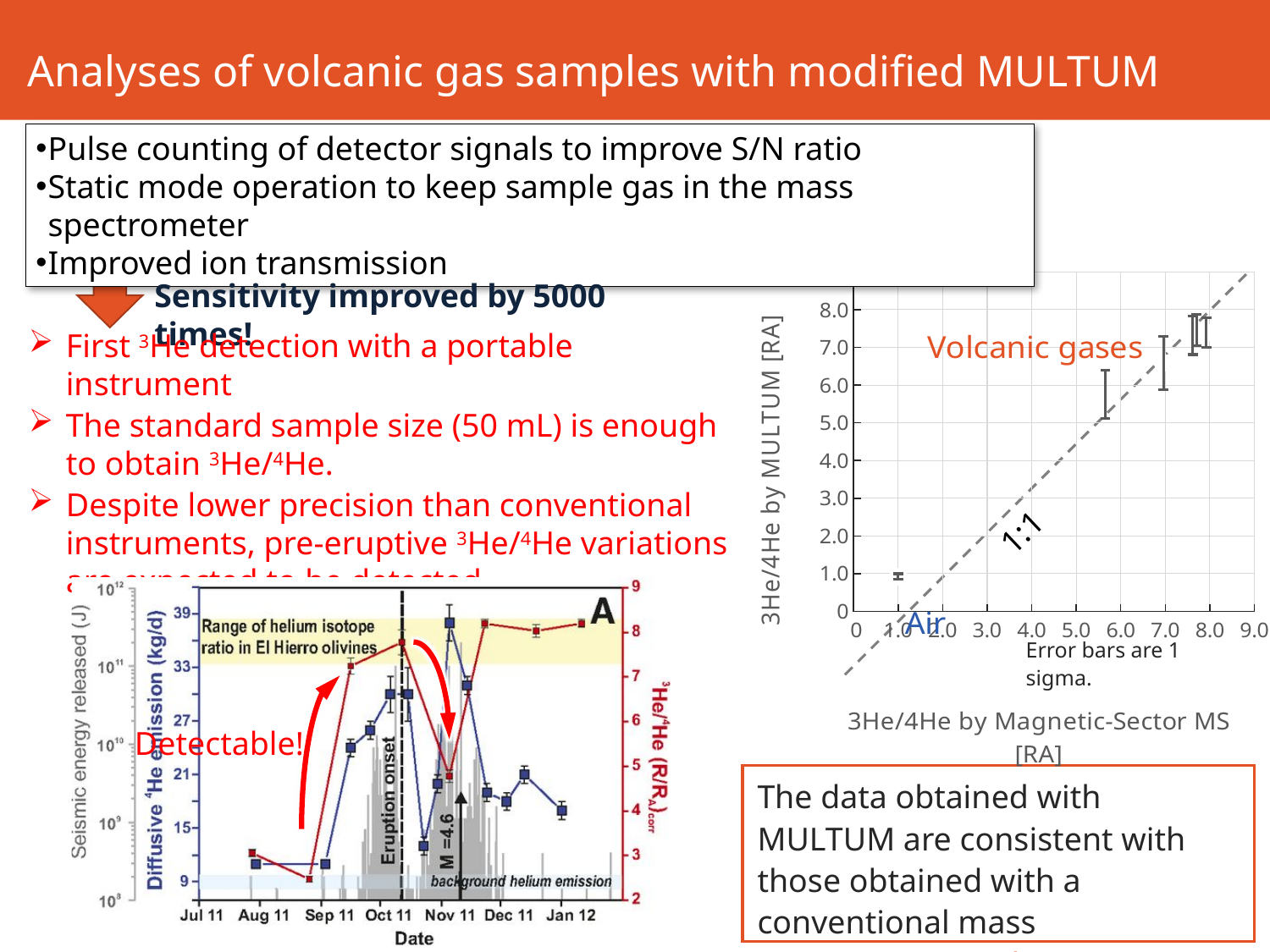
In the chart at the bottom left of the slide, does the red 3He/4He series rise or fall between Aug 11 and Oct 11? rise What kind of chart is the chart at the bottom left of the slide (Diffusive 4He emission versus Date)? line chart What kind of chart is the chart on the right of the slide (3He/4He by MULTUM versus 3He/4He by Magnetic-Sector MS)? scatter chart In the chart at the bottom left of the slide, how many date labels are shown along the horizontal axis? 7 In the chart at the bottom left of the slide, is the peak value of the red 3He/4He (R/RA) series near Oct 11 greater or less than 7 on the right-hand axis? greater In the chart at the bottom left of the slide, is the peak value of the blue Diffusive 4He emission series near Nov 11 greater or less than 33 kg/d? greater In the chart on the right of the slide, is the 3He/4He by MULTUM value for the Air point greater or less than 2.0? less In the chart on the right of the slide, what is the highest tick value shown on the horizontal axis? 9.0 In the chart on the right of the slide, what is the label of the vertical axis? 3He/4He by MULTUM [RA] In the chart on the right of the slide, which group of points has the higher 3He/4He values, Air or Volcanic gases? Volcanic gases In the chart on the right of the slide, what is the label of the horizontal axis? 3He/4He by Magnetic-Sector MS [RA]